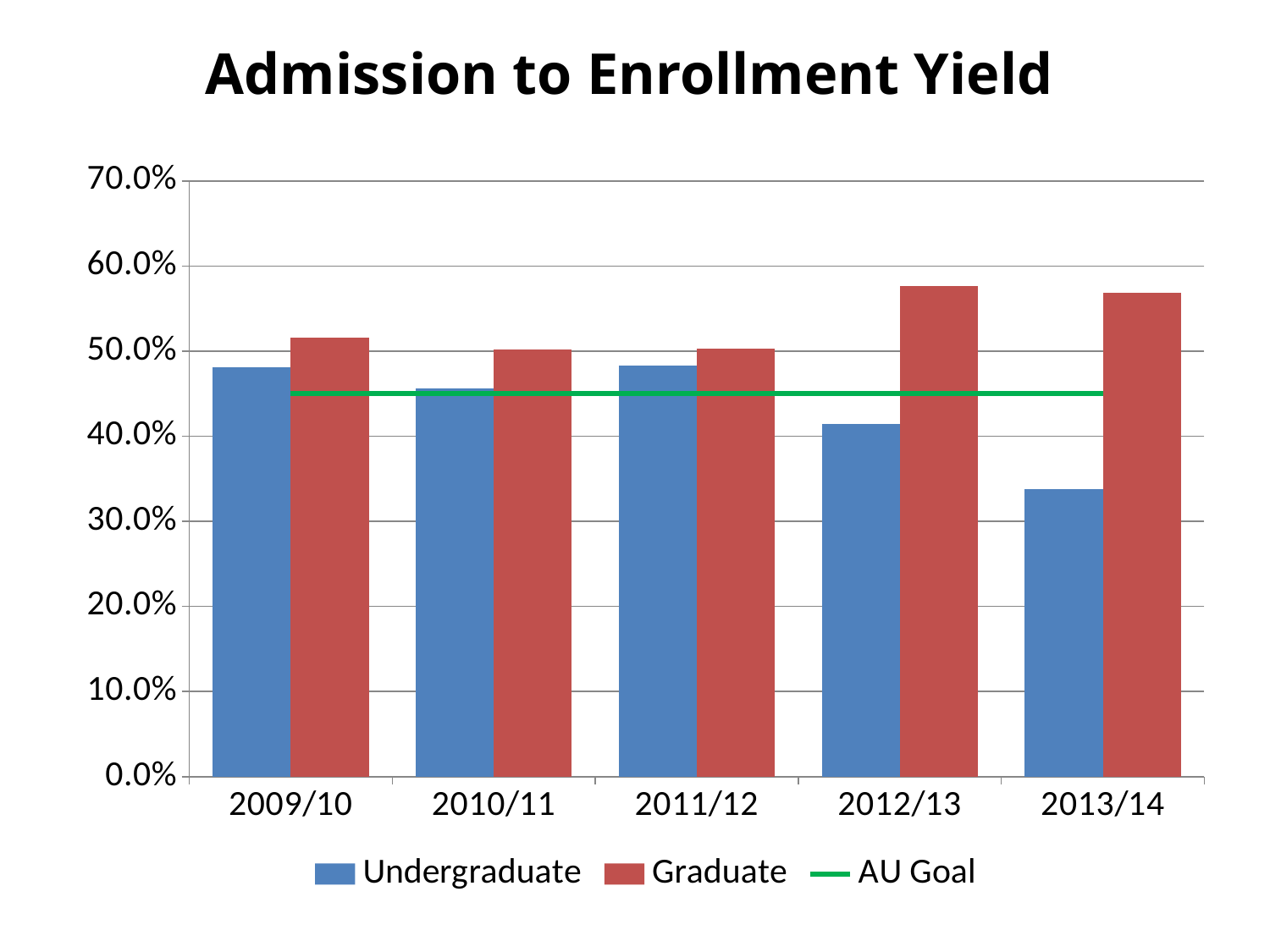
Do the Undergraduate values rise or fall from 2011/12 to 2013/14? fall How many series does the legend list? 3 What colour is the AU Goal line? green How many academic years are shown on the x axis? 5 What is the title of the chart? Admission to Enrollment Yield Is the Undergraduate value for 2013/14 greater or less than 40.0%? less Which is larger, the Undergraduate value for 2009/10 or the Undergraduate value for 2013/14? 2009/10 What kind of chart is used to show the Undergraduate and Graduate values? bar chart In 2013/14, which is larger, the Undergraduate value or the Graduate value? Graduate Which year has the lowest Undergraduate value? 2013/14 Is the Undergraduate value for 2009/10 greater or less than 50.0%? less Is the Graduate value for 2012/13 greater or less than 50.0%? greater